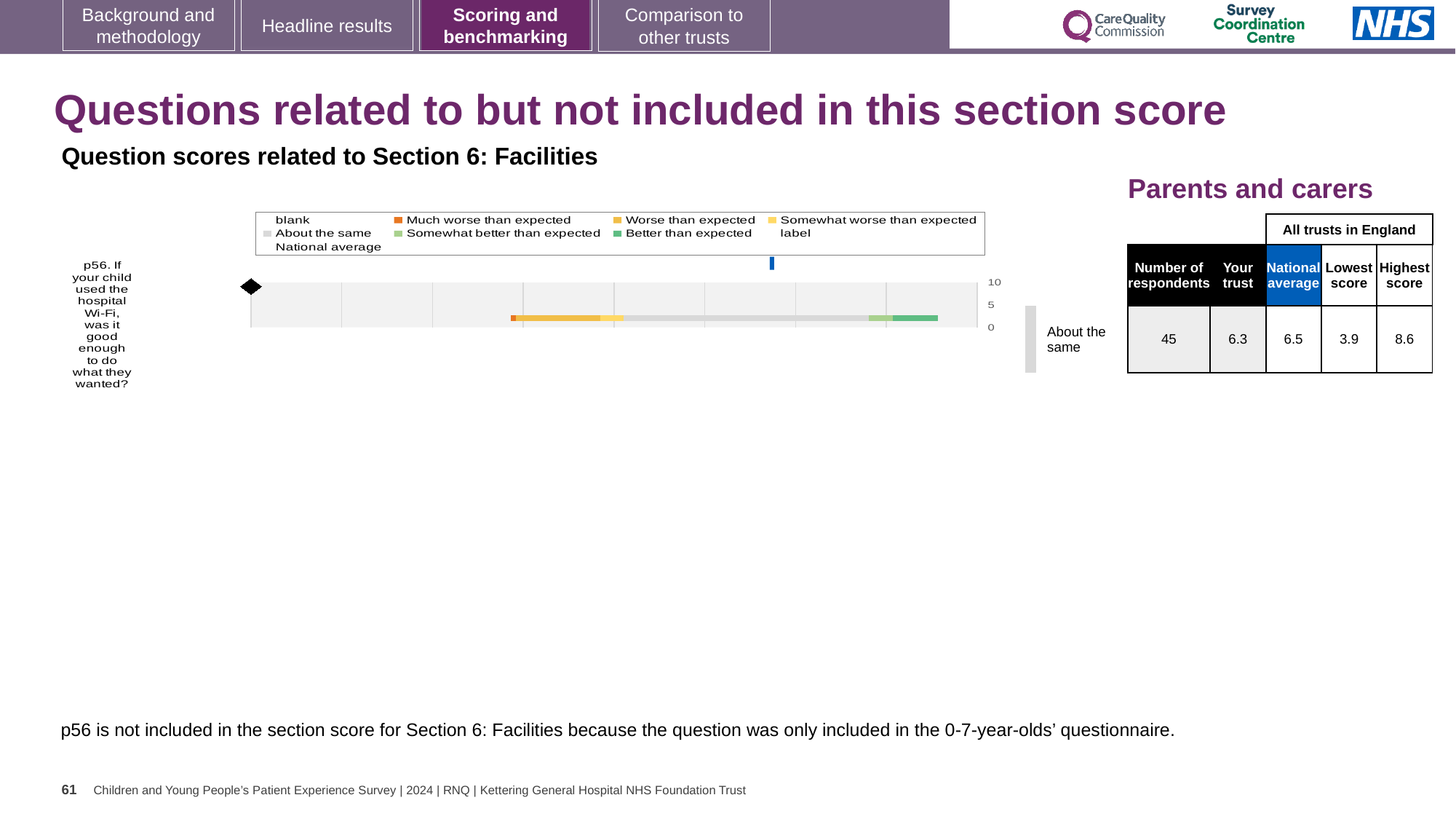
Which is larger for p56, the 'Your trust' score or the national average? National average What is the lowest score across all trusts in England for p56? 3.9 How many entries does the chart legend list? 9 Which question number is plotted in the chart? p56 What is the highest score across all trusts in England for p56? 8.6 What is the difference between the highest score (8.6) and the lowest score (3.9) for p56? 4.7 What is the national average score for p56 in the table beside the chart? 6.5 What kind of chart is used to show the p56 question score? bar chart What is the 'Your trust' score for p56 in the table beside the chart? 6.3 What is the highest value shown on the chart's axis? 10 How many questions (categories) are plotted in the chart? 1